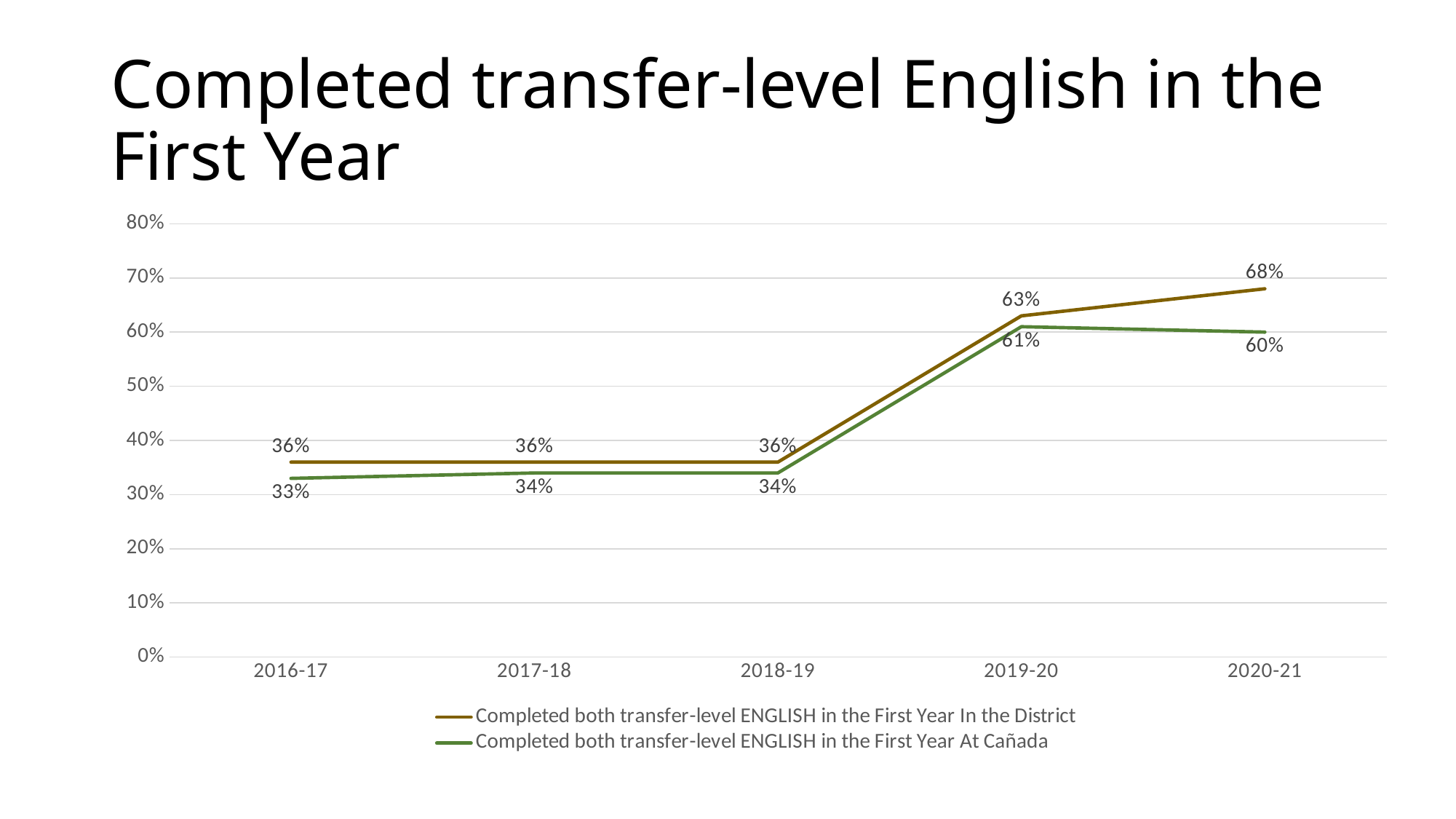
What was the value for 'In the District' in 2020-21? 68% What is the difference between the 'In the District' and 'At Cañada' values in 2020-21? 8% How many years are shown on the x axis? 5 In which year was the 'At Cañada' value lowest? 2016-17 Which series had the larger value in 2018-19, 'In the District' or 'At Cañada'? In the District What is the title of the chart? Completed transfer-level English in the First Year In which year was the 'In the District' value highest? 2020-21 How many series does the legend list? 2 Did the 'In the District' value rise or fall from 2018-19 to 2019-20? rise What was the value for 'At Cañada' in 2016-17? 33% What kind of chart is shown on the slide? line chart What was the value for 'At Cañada' in 2019-20? 61%